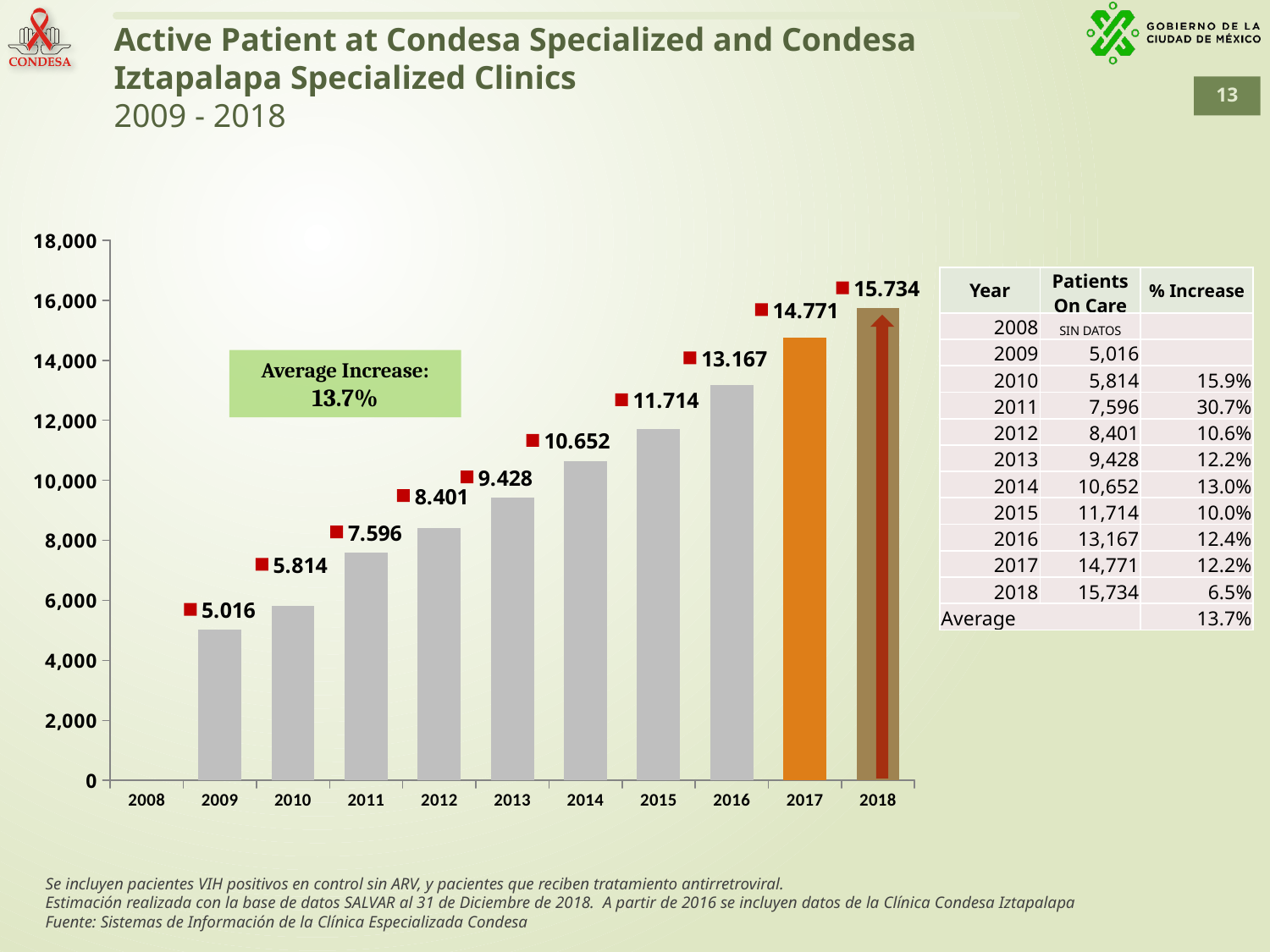
Which year has a larger value, 2015 or 2016? 2016 Do the values rise or fall from 2009 to 2018? rise What is the value shown for 2018 on the chart? 15.734 What is the value shown for 2009 on the chart? 5.016 What is the difference between the values for 2018 and 2017? 963 Which year with a plotted bar has the lowest number of active patients? 2009 How many bars are plotted on the chart? 10 What is the value shown for 2013 on the chart? 9.428 What kind of chart is shown on the slide? bar chart What average increase is stated in the box on the chart? 13.7% Is the value for 2014 greater or less than 10,000? greater Which year has the highest number of active patients on the chart? 2018